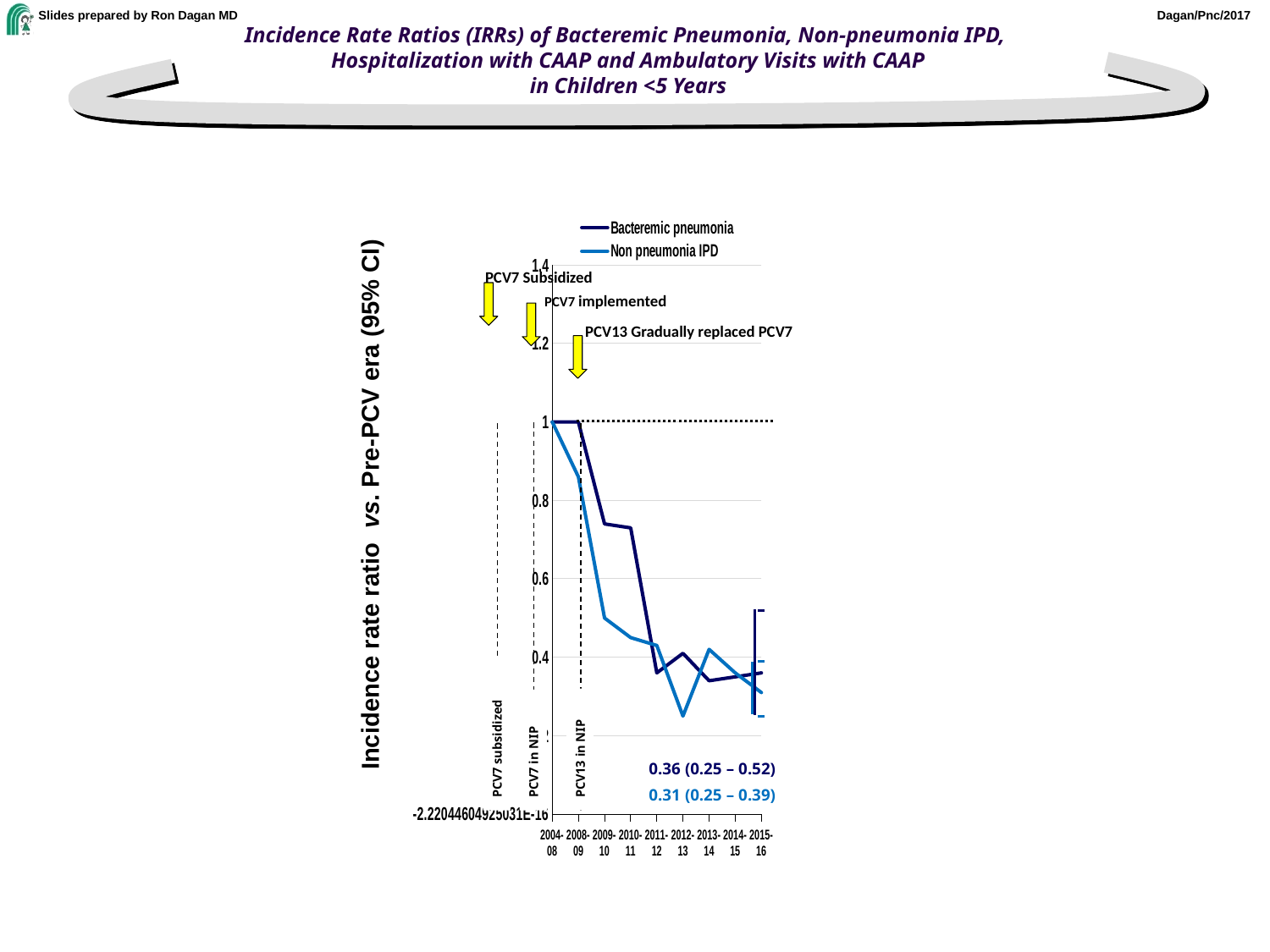
Do the incidence rate ratios generally rise or fall from 2004-08 to 2015-16? fall How many series does the chart legend list? 2 What kind of chart is shown on the slide? line chart What is the labelled incidence rate ratio for Non pneumonia IPD in 2015-16? 0.31 (0.25 – 0.39) What is the title of the chart's y axis? Incidence rate ratio vs. Pre-PCV era (95% CI) Is the value for Non pneumonia IPD in 2009-10 greater or less than 0.6? less What is the labelled incidence rate ratio for Bacteremic pneumonia in 2015-16? 0.36 (0.25 – 0.52) In 2010-11, which series has the higher value, Bacteremic pneumonia or Non pneumonia IPD? Bacteremic pneumonia Is the value for Bacteremic pneumonia in 2010-11 greater or less than 0.8? less In 2015-16, which series has the higher incidence rate ratio, Bacteremic pneumonia or Non pneumonia IPD? Bacteremic pneumonia How many time periods are shown along the x axis of the chart? 9 What is the difference between the 2015-16 point estimates for Bacteremic pneumonia (0.36) and Non pneumonia IPD (0.31)? 0.05